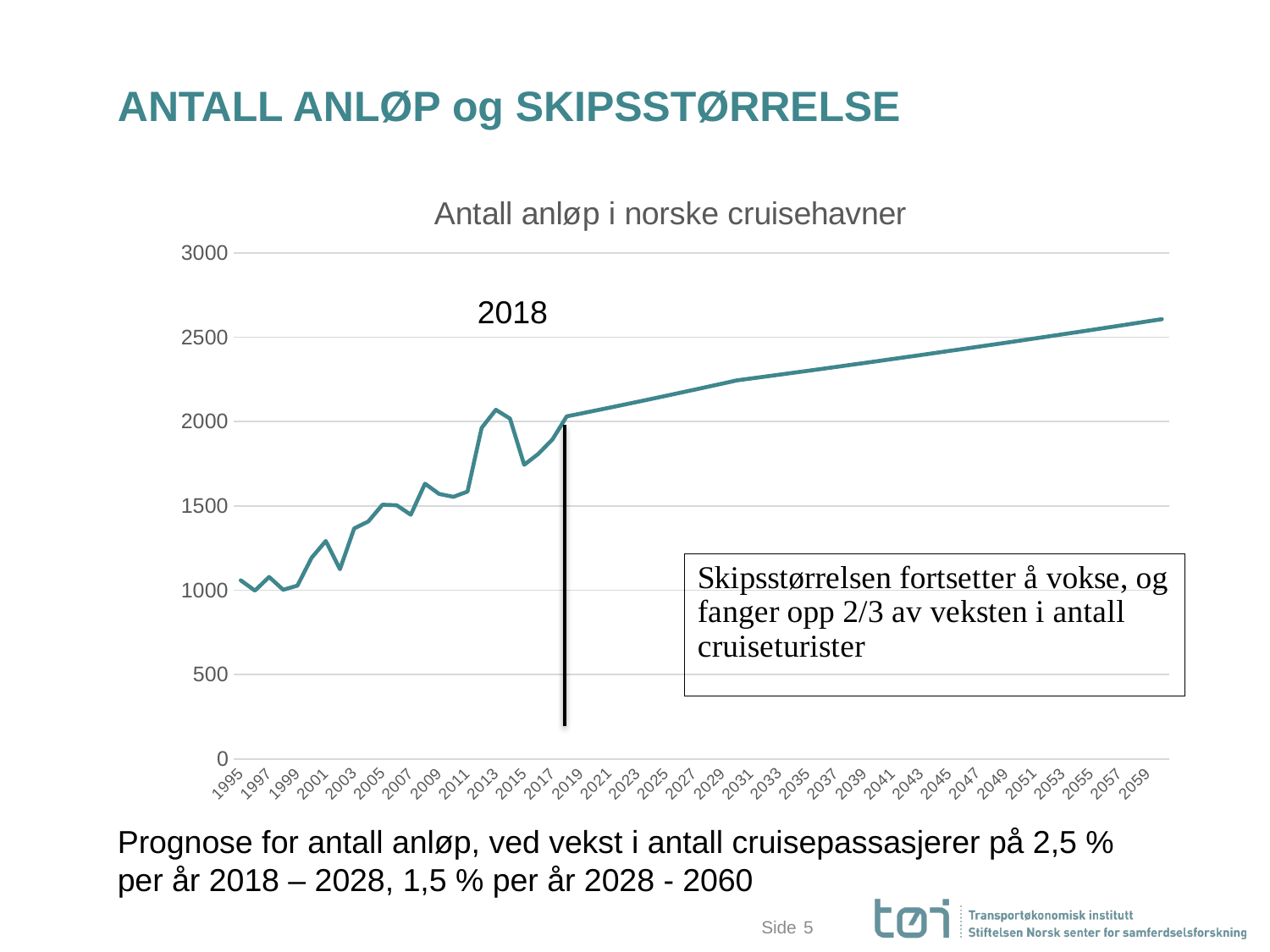
Is the value for 2045 greater or less than 2000? greater Which year is marked by the vertical black line on the chart? 2018 Is the value for 1995 greater or less than 1500? less Overall, do the values rise or fall from 1995 to 2059? rise What is the title of the chart? Antall anløp i norske cruisehavner Is the value for 2059 greater or less than 3000? less Which year has the larger value, 2013 or 2015? 2013 What kind of chart is shown on the slide? line chart Which year has the larger value, 1995 or 2059? 2059 What is the highest value shown on the vertical axis? 3000